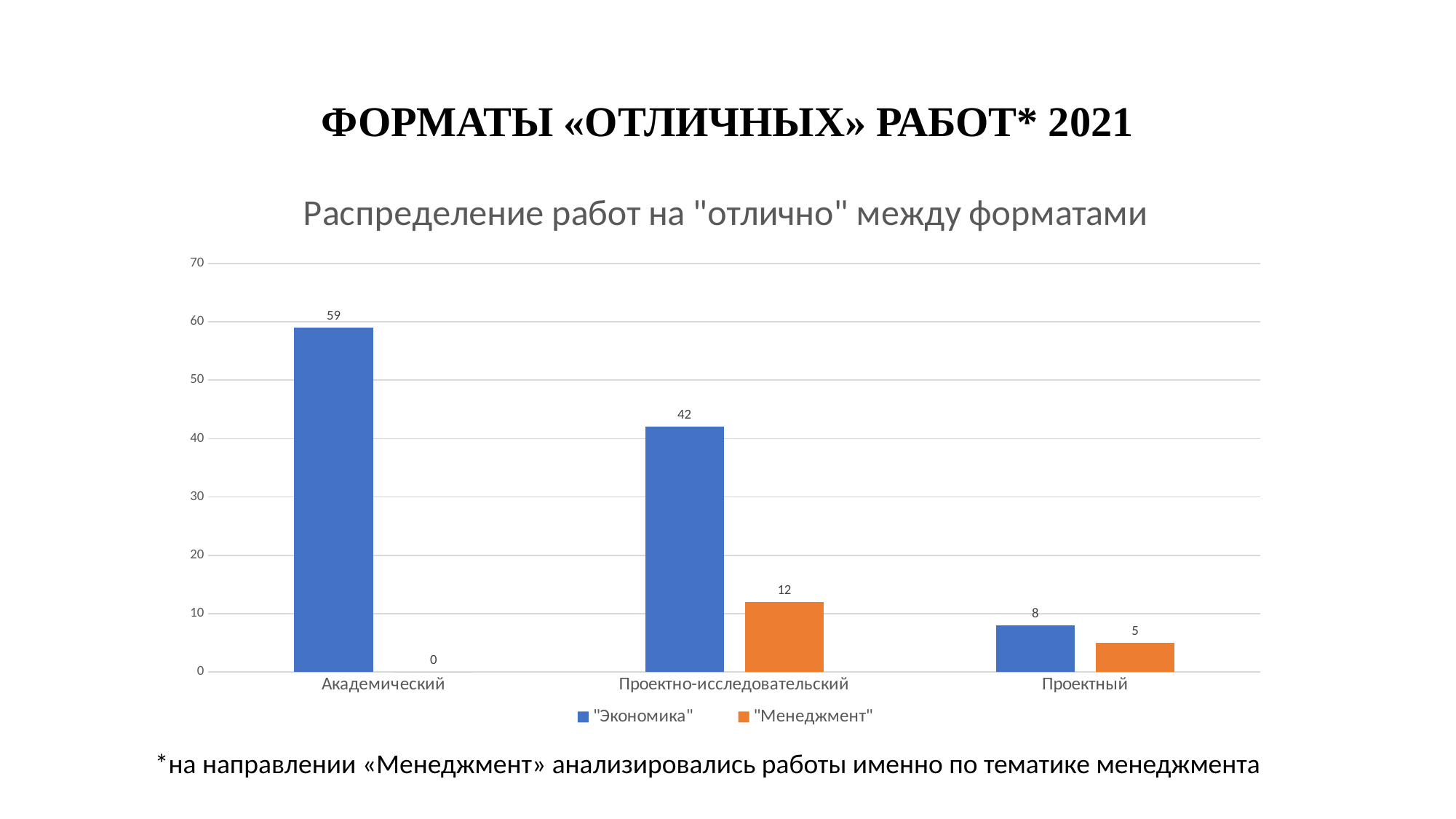
What is the value for "Менеджмент" in the Академический category? 0 What kind of chart is shown on the slide? Bar chart Which is larger: the "Экономика" value for Проектный or the "Менеджмент" value for Проектный? "Экономика" What is the value for "Экономика" in the Проектный category? 8 What is the value for "Экономика" in the Академический category? 59 What is the title of the chart? Распределение работ на "отлично" между форматами How many categories are shown on the x axis? 3 Which category has the lowest value for "Менеджмент"? Академический What is the difference between the "Экономика" and "Менеджмент" values in the Проектно-исследовательский category? 30 How many series does the legend list? 2 What is the value for "Менеджмент" in the Проектно-исследовательский category? 12 Which category has the highest value for "Экономика"? Академический